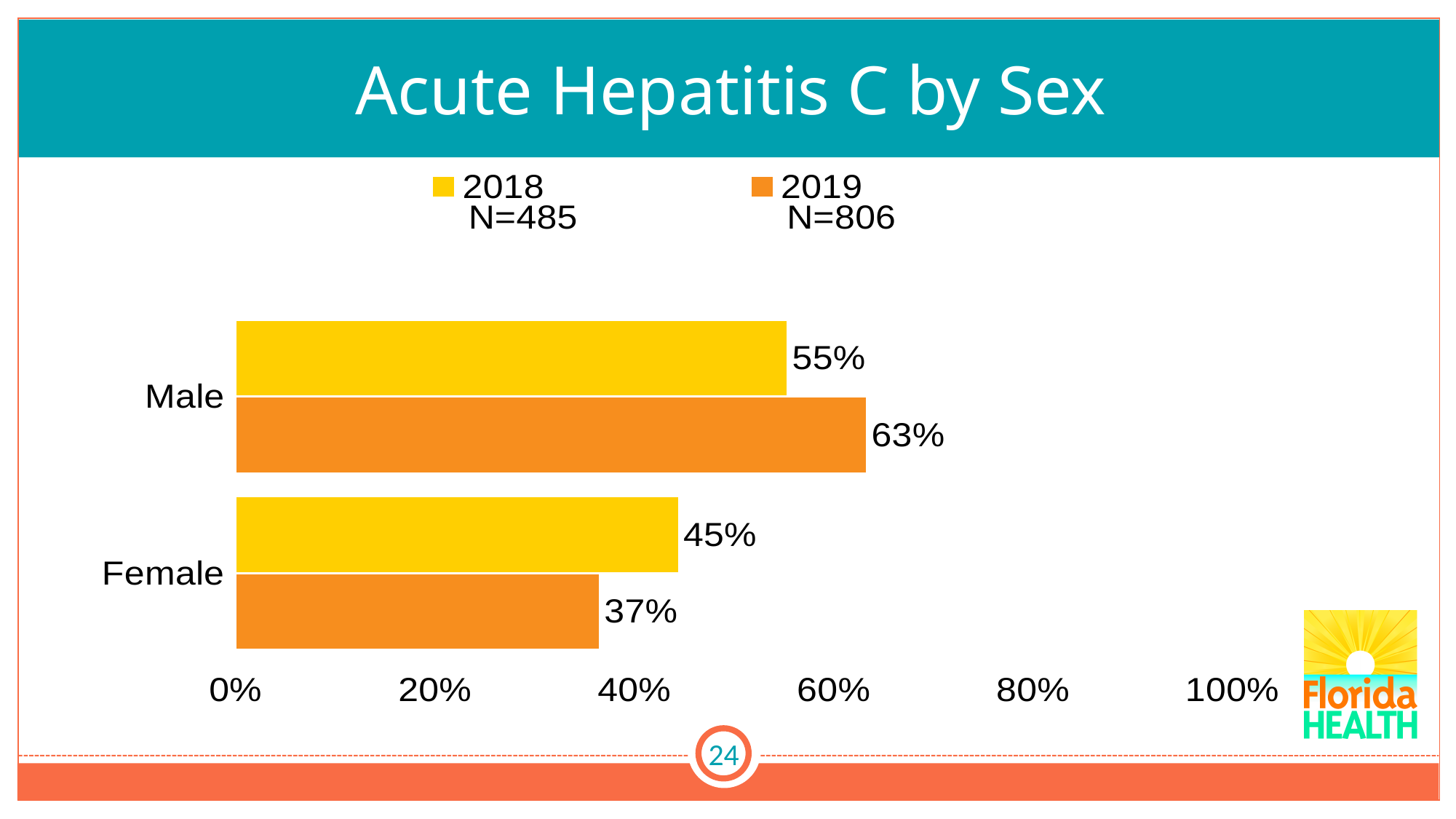
Was the female share of cases larger in 2018 or 2019? 2018 What is the N (number of cases) for 2019 shown in the legend? N=806 What type of chart is shown on the slide? Bar chart By how many percentage points did the male share of cases increase from 2018 to 2019? 8 percentage points What is the difference between the male and female shares in 2019? 26 percentage points What percentage of acute hepatitis C cases were male in 2019? 63% Which sex had the higher share of acute hepatitis C cases in 2019? Male What percentage of acute hepatitis C cases were female in 2019? 37% What percentage of acute hepatitis C cases were male in 2018? 55% How many series does the legend list? 2 Which sex had the lower share of acute hepatitis C cases in 2018? Female What percentage of acute hepatitis C cases were female in 2018? 45%